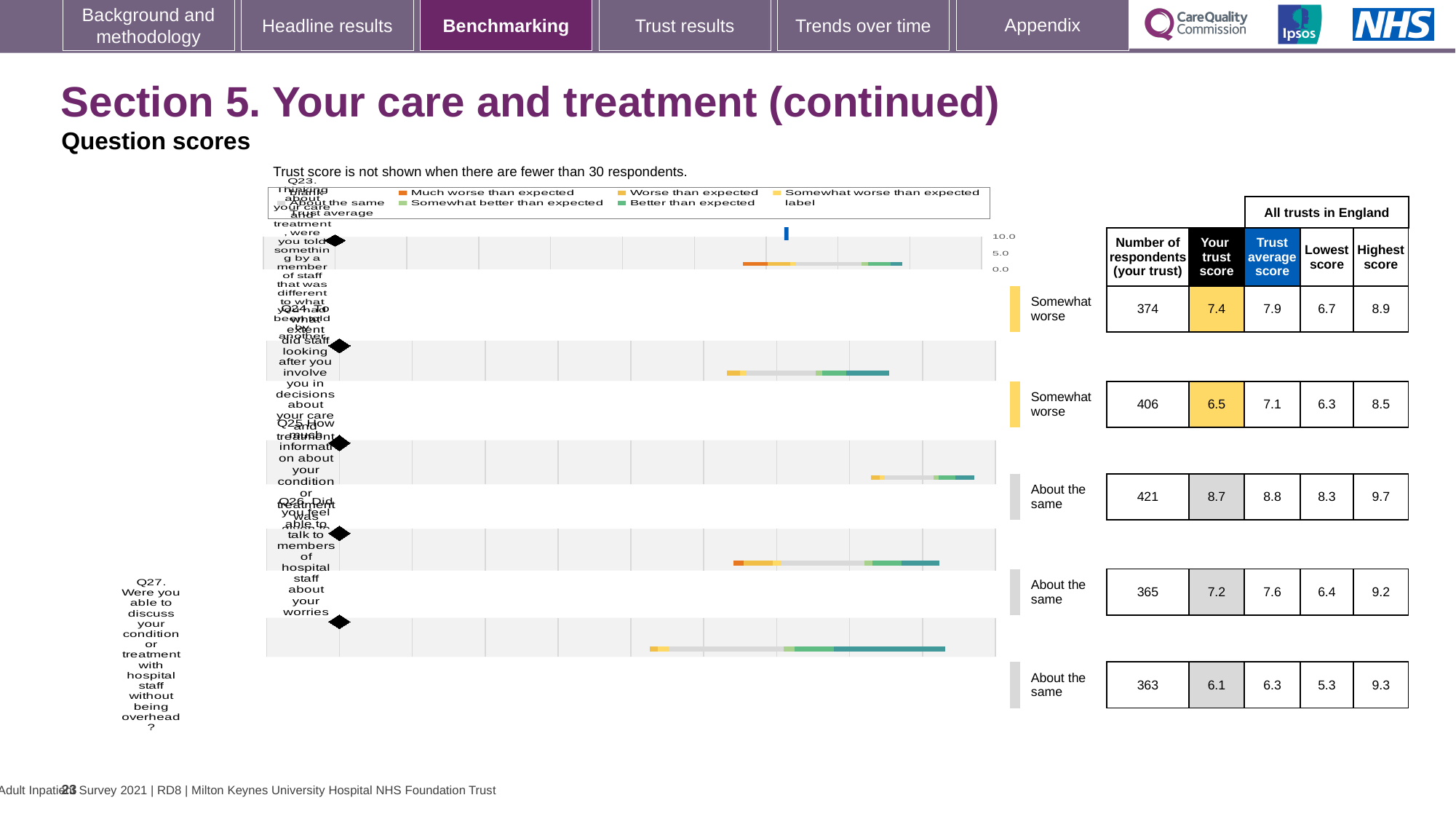
What is the highest score across all trusts in England for Q26? 9.2 What is the lowest score across all trusts in England for Q27? 5.3 How many questions are shown in the chart? 5 Which is larger for Q24: the trust score or the trust average score? Trust average score How many respondents answered Q24 (to what extent did staff involve you in decisions about your care and treatment)? 406 What is the difference between the trust average score and the trust score for Q23? 0.5 What is the trust score for Q25 (how much information about your condition or treatment was given)? 8.7 Which question has the lowest trust score? Q27 Which question has the highest trust score? Q25 What is the trust average score for Q27 (were you able to discuss your condition or treatment without being overheard)? 6.3 What kind of chart is used to show the question scores? Bar chart What benchmark category is shown for Q23? Somewhat worse